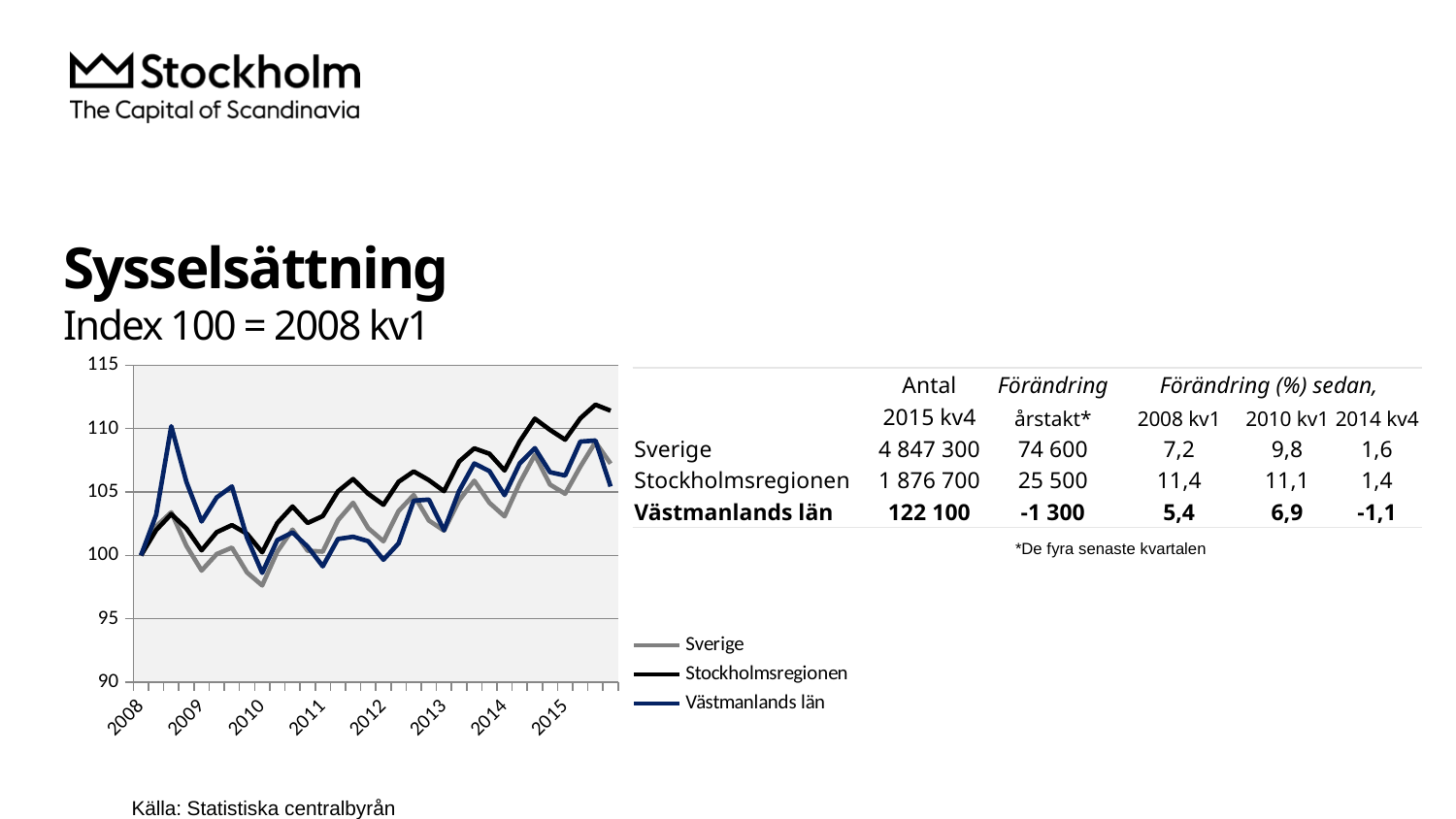
What kind of chart is shown on the slide? line chart What is the highest value shown on the chart's y axis? 115 What is the index value of all three series at 2008 kv1, the base period of the chart? 100 At the end of the chart, which is larger: the value for Stockholmsregionen or the value for Västmanlands län? Stockholmsregionen Is the value for Sverige at the end of the chart greater or less than 105? greater Which series are listed in the chart legend? Sverige, Stockholmsregionen, Västmanlands län How many series does the chart legend list? 3 How many year labels are shown on the x axis of the chart? 8 Does the Stockholmsregionen series generally rise or fall from 2008 to 2015? rise Is the value for Stockholmsregionen at the end of the chart greater or less than 110? greater Is the lowest value for Sverige around 2010 greater or less than 100? less Which series has the highest index value at the end of the chart (2015)? Stockholmsregionen